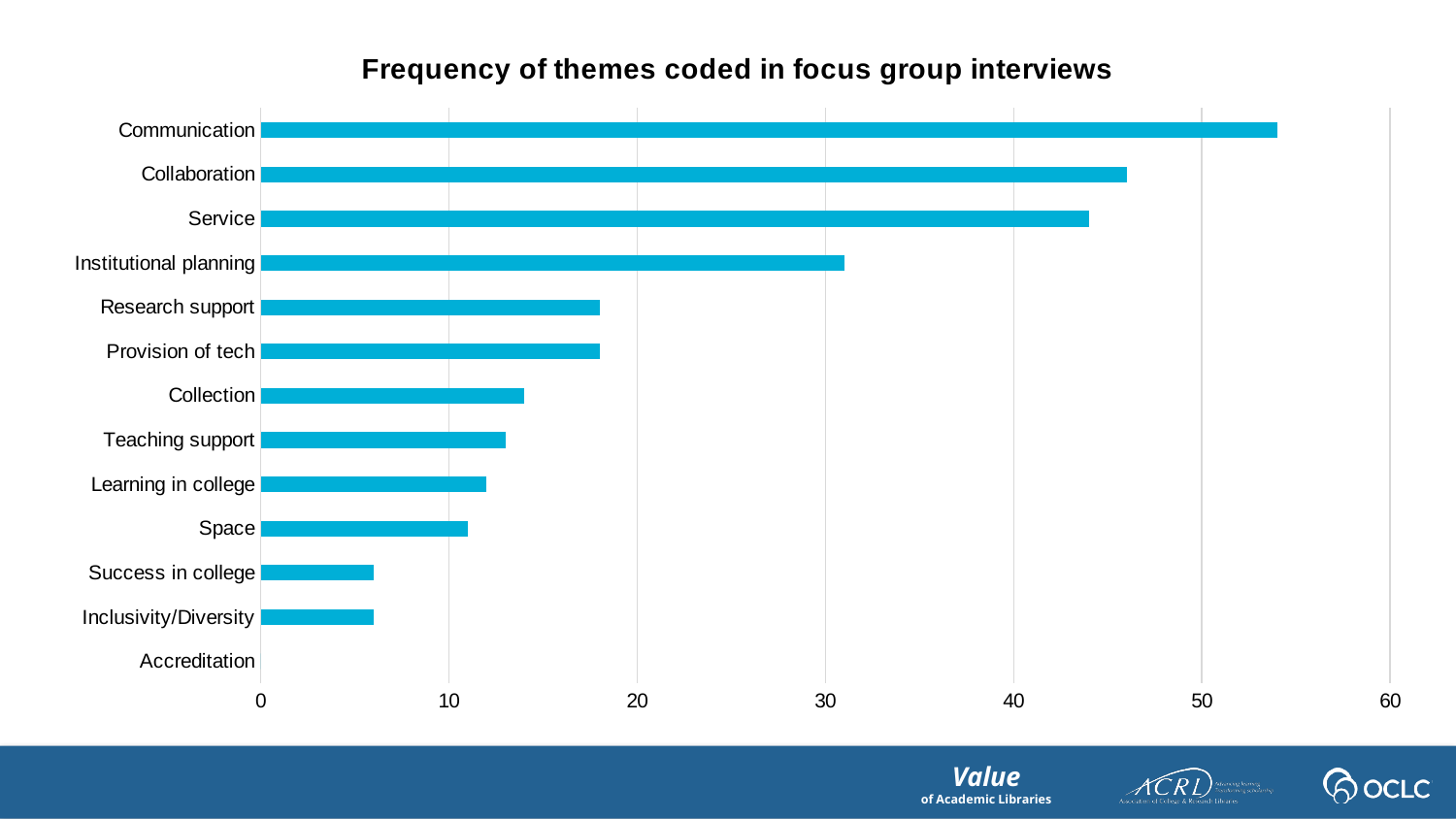
Which theme has the lowest frequency? Accreditation How many themes (categories) are listed on the chart? 13 Which has a higher frequency, Communication or Collaboration? Communication What kind of chart is shown on the slide? bar chart Is the value for Success in college greater or less than 10? less Is the value for Communication greater or less than 50? greater Which theme has the highest frequency? Communication Is the value for Collaboration greater or less than 40? greater Which has a higher frequency, Service or Institutional planning? Service What is the title of the chart? Frequency of themes coded in focus group interviews